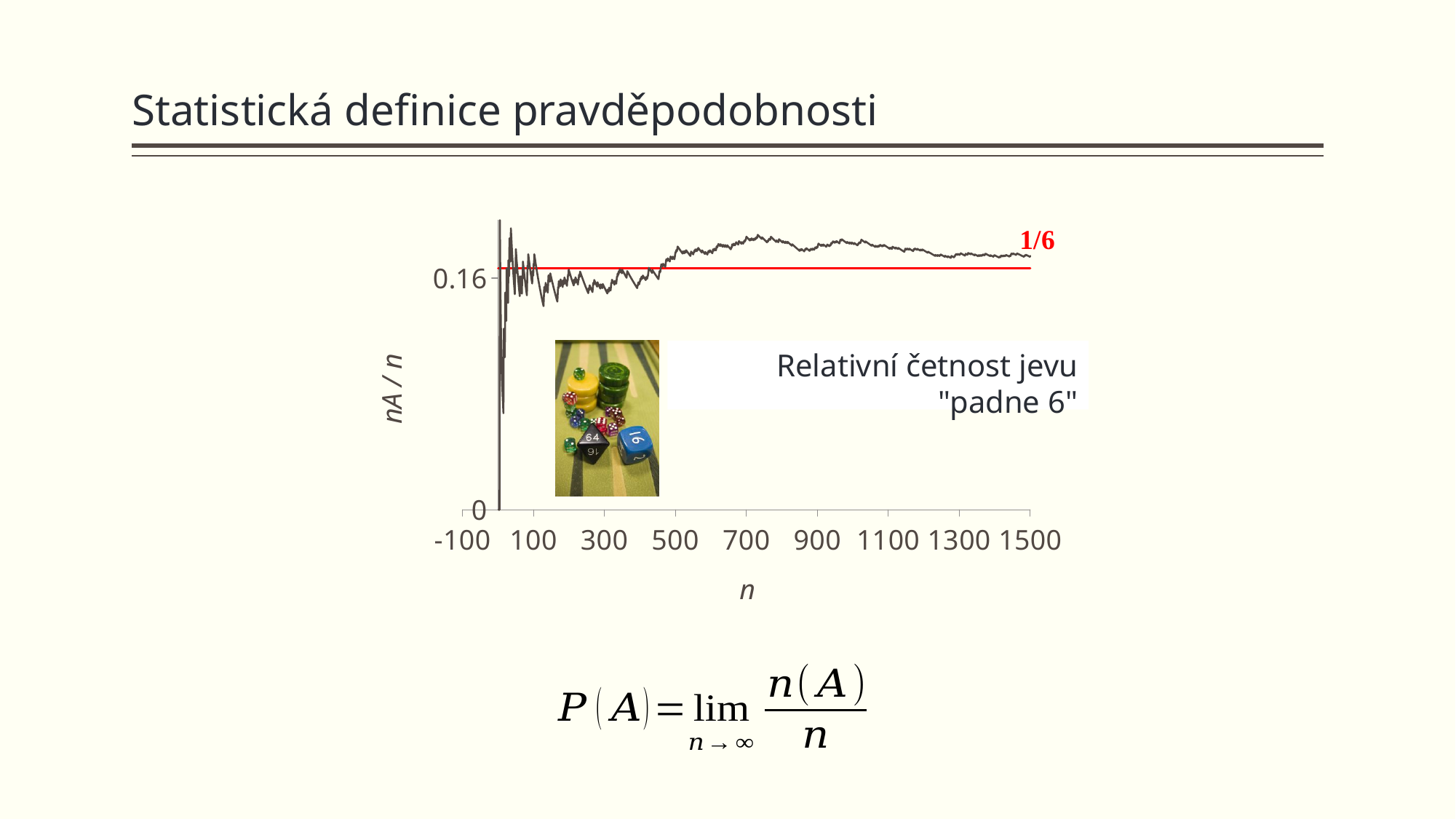
Is the plotted value at n = 300 greater or less than 0.16? less What kind of chart is shown on the slide? line chart Which is larger: the plotted value at n = 700 or the plotted value at n = 300? n = 700 Does the plotted line fluctuate more strongly at small n or at large n? small n What is the largest tick label shown on the horizontal axis? 1500 What is the label on the vertical axis of the chart? nA / n Is the plotted value at n = 900 greater or less than 0.16? greater What is the smallest tick label shown on the horizontal axis? -100 How many tick labels are shown on the horizontal axis? 9 What value is the red horizontal reference line labelled with? 1/6 Is the plotted value at n = 1500 greater or less than 0.16? greater